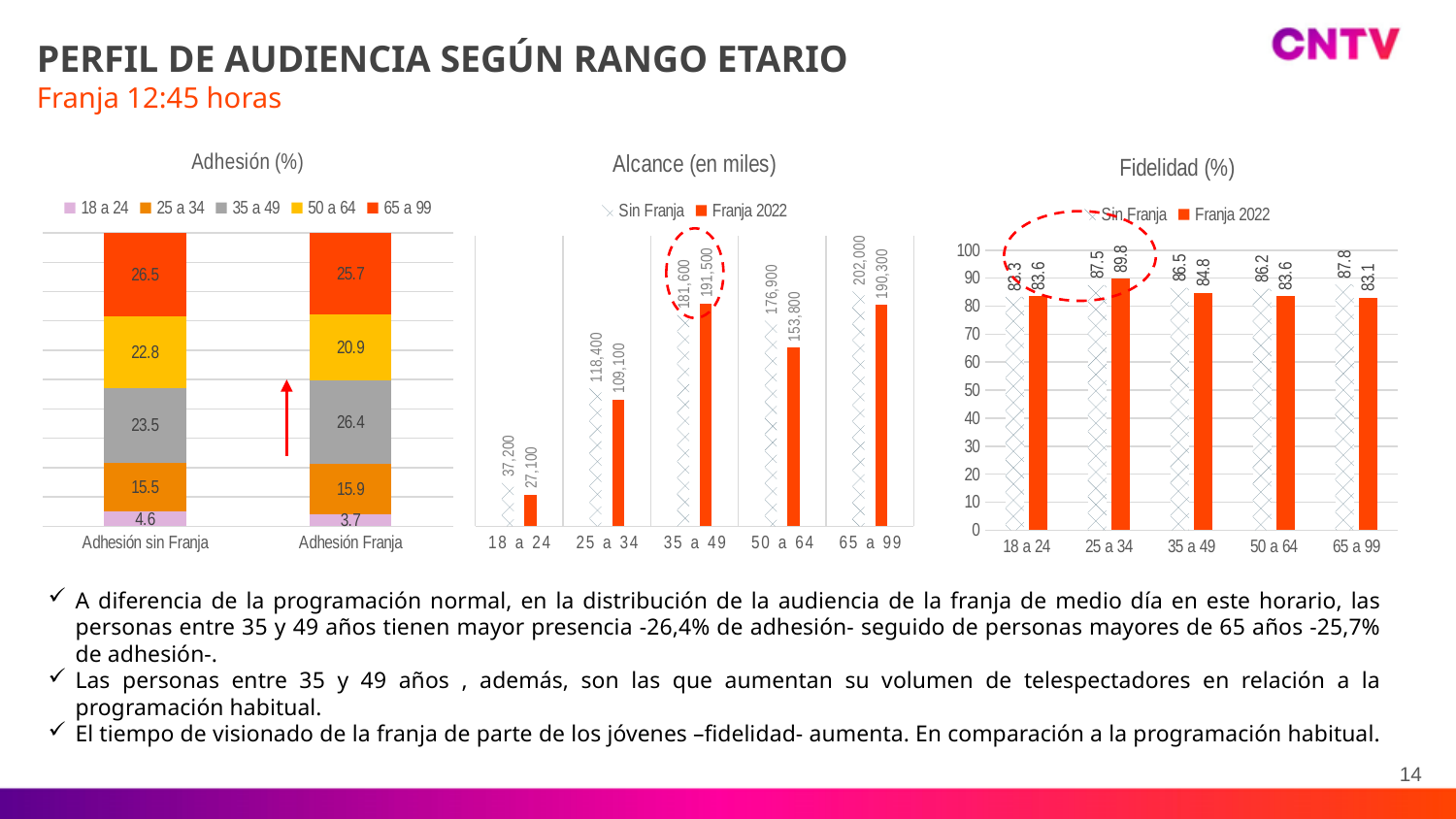
What kind of chart is the 'Fidelidad (%)' chart? Bar chart In the 'Alcance (en miles)' chart, how many age categories are shown on the x axis? 5 In the 'Adhesión (%)' chart, which segment is the largest in the 'Adhesión sin Franja' bar? 65 a 99 In the 'Alcance (en miles)' chart, which is larger for 50 a 64: Sin Franja or Franja 2022? Sin Franja In the 'Adhesión (%)' chart, what is the difference between the 65 a 99 values of 'Adhesión sin Franja' and 'Adhesión Franja'? 0.8 In the 'Alcance (en miles)' chart, which age group has the lowest Sin Franja value? 18 a 24 In the 'Alcance (en miles)' chart, what is the Franja 2022 value for 35 a 49? 191,500 In the 'Fidelidad (%)' chart, what is the difference between the Sin Franja and Franja 2022 values for 65 a 99? 4.7 In the 'Adhesión (%)' chart, what is the value for the 18 a 24 segment in the 'Adhesión sin Franja' bar? 4.6 In the 'Fidelidad (%)' chart, what is the Franja 2022 value for 25 a 34? 89.8 In the 'Adhesión (%)' chart, what is the value for the 35 a 49 segment in the 'Adhesión Franja' bar? 26.4 In the 'Adhesión (%)' chart, how many series does the legend list? 5